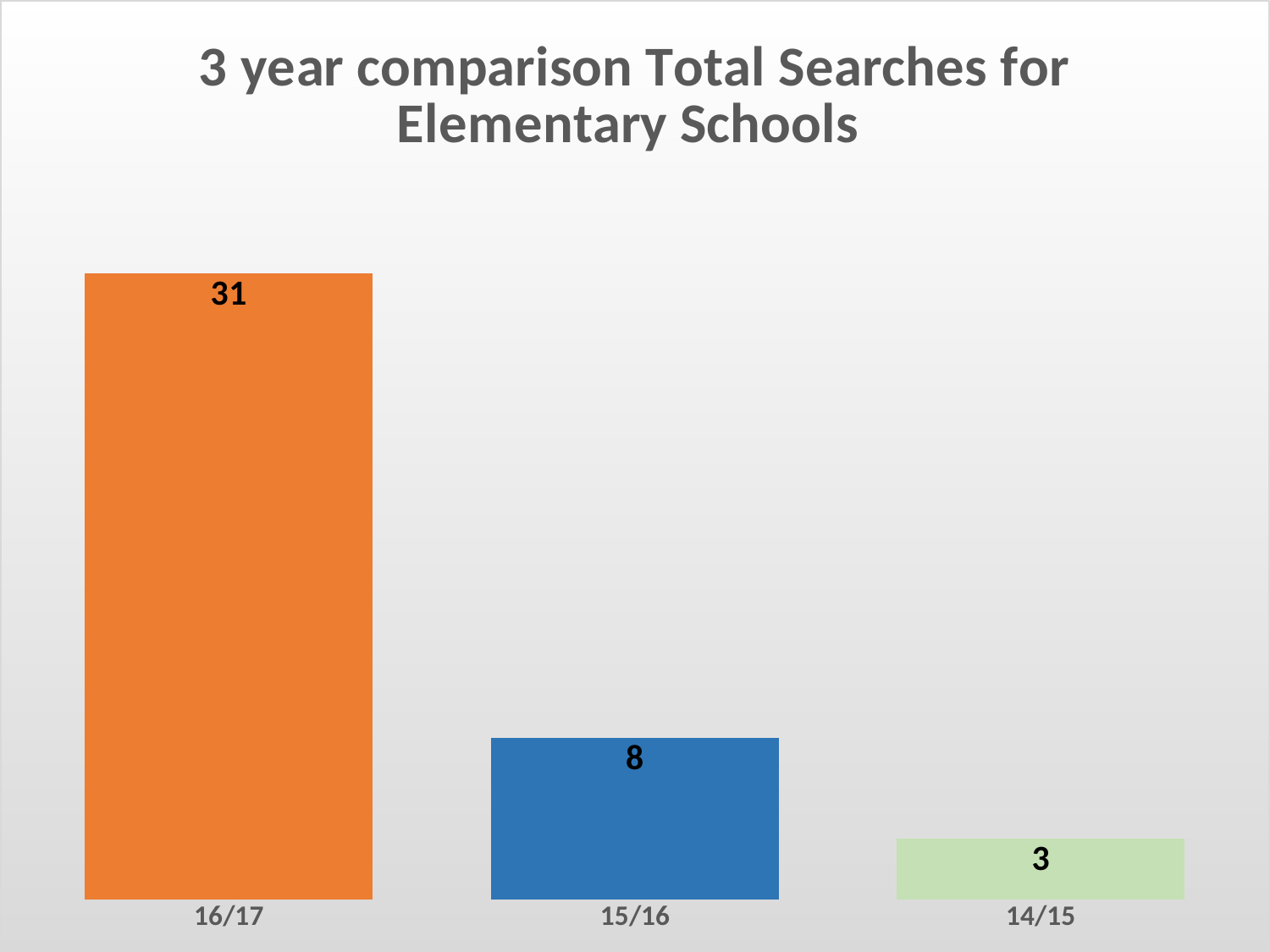
Which year has the highest total searches? 16/17 What is the value for 16/17? 31 What is the title of the chart? 3 year comparison Total Searches for Elementary Schools What is the difference between the values for 16/17 and 15/16? 23 What is the difference between the values for 15/16 and 14/15? 5 Which is larger, the value for 15/16 or the value for 14/15? 15/16 Which year has the lowest total searches? 14/15 What is the value for 15/16? 8 Do the values rise or fall from left to right along the x axis? fall How many categories are shown on the chart? 3 What kind of chart is this? bar chart What is the value for 14/15? 3